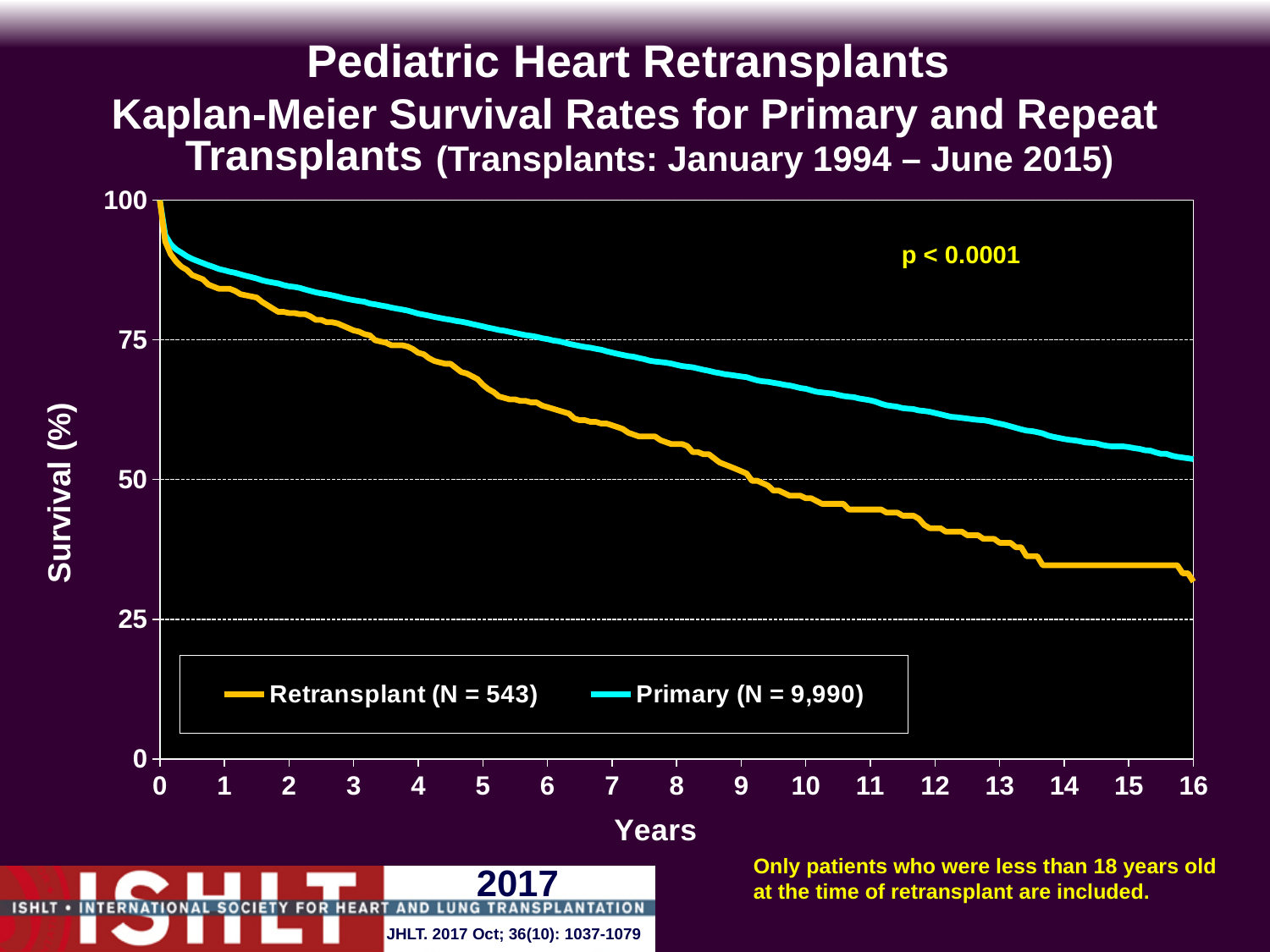
How many series does the legend list? 2 At year 8, which series has the higher survival, Retransplant or Primary? Primary Do the survival values rise or fall as years increase along the x axis? fall Is the survival value for Primary at year 10 greater or less than 50? greater Is the survival value for Primary at year 5 greater or less than 75? greater Is the survival value for Retransplant at year 15 greater or less than 25? greater What p-value is printed on the chart? p < 0.0001 What is the N value given in the legend for the Retransplant series? 543 What kind of chart is shown on the slide? line chart What is the survival value for both series at year 0? 100